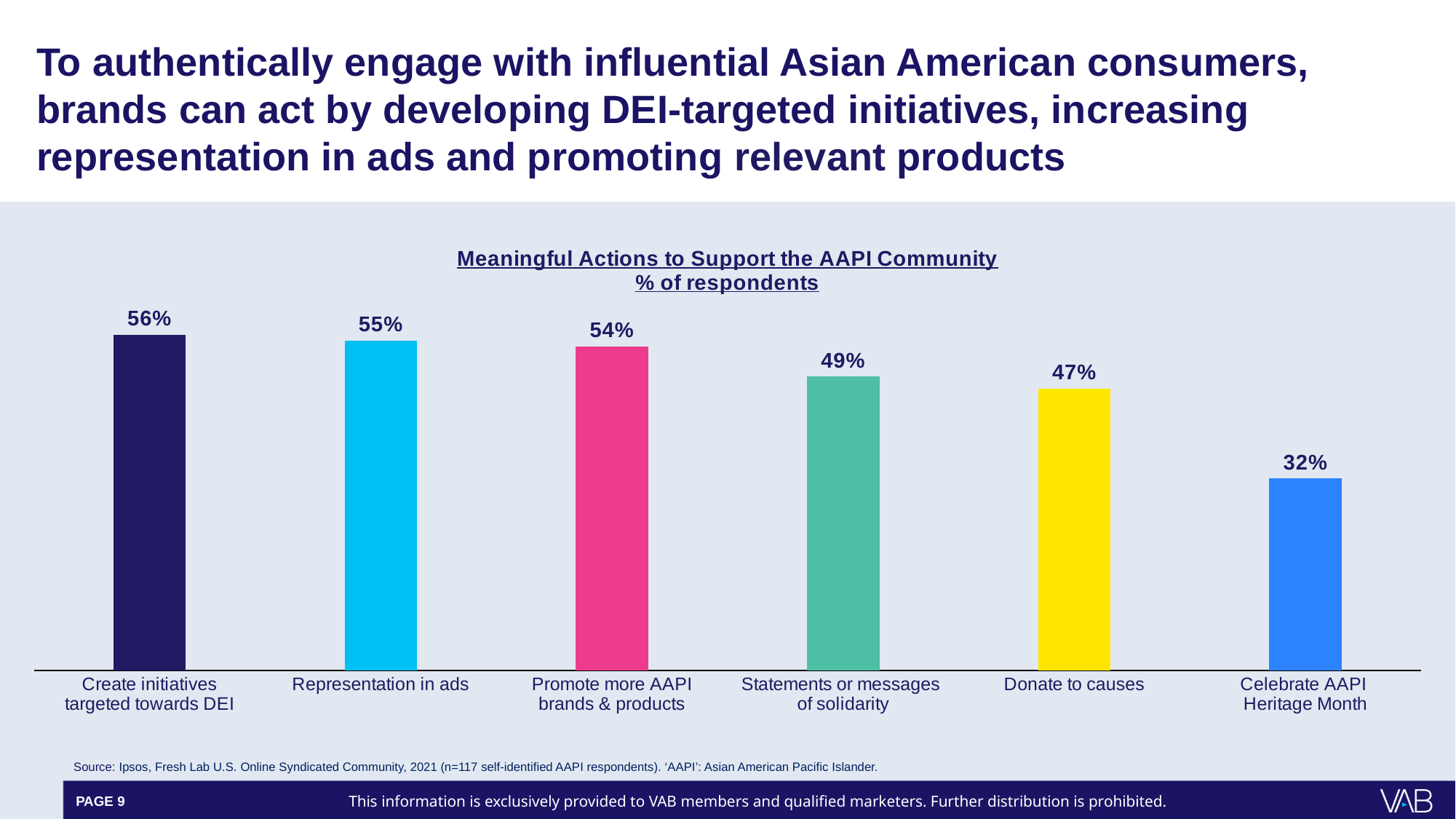
What is the value for 'Donate to causes'? 47% Which action has the lowest share of respondents? Celebrate AAPI Heritage Month What is the value for 'Statements or messages of solidarity'? 49% What percentage of respondents chose 'Celebrate AAPI Heritage Month'? 32% What percentage of respondents chose 'Create initiatives targeted towards DEI'? 56% What is the difference between 'Promote more AAPI brands & products' and 'Donate to causes'? 7 percentage points What is the title of the chart? Meaningful Actions to Support the AAPI Community % of respondents How many actions are shown in the chart? 6 Which is larger: 'Statements or messages of solidarity' or 'Donate to causes'? Statements or messages of solidarity What is the difference between 'Representation in ads' and 'Celebrate AAPI Heritage Month'? 23 percentage points Which action has the highest share of respondents? Create initiatives targeted towards DEI What kind of chart is shown on the slide? Bar chart